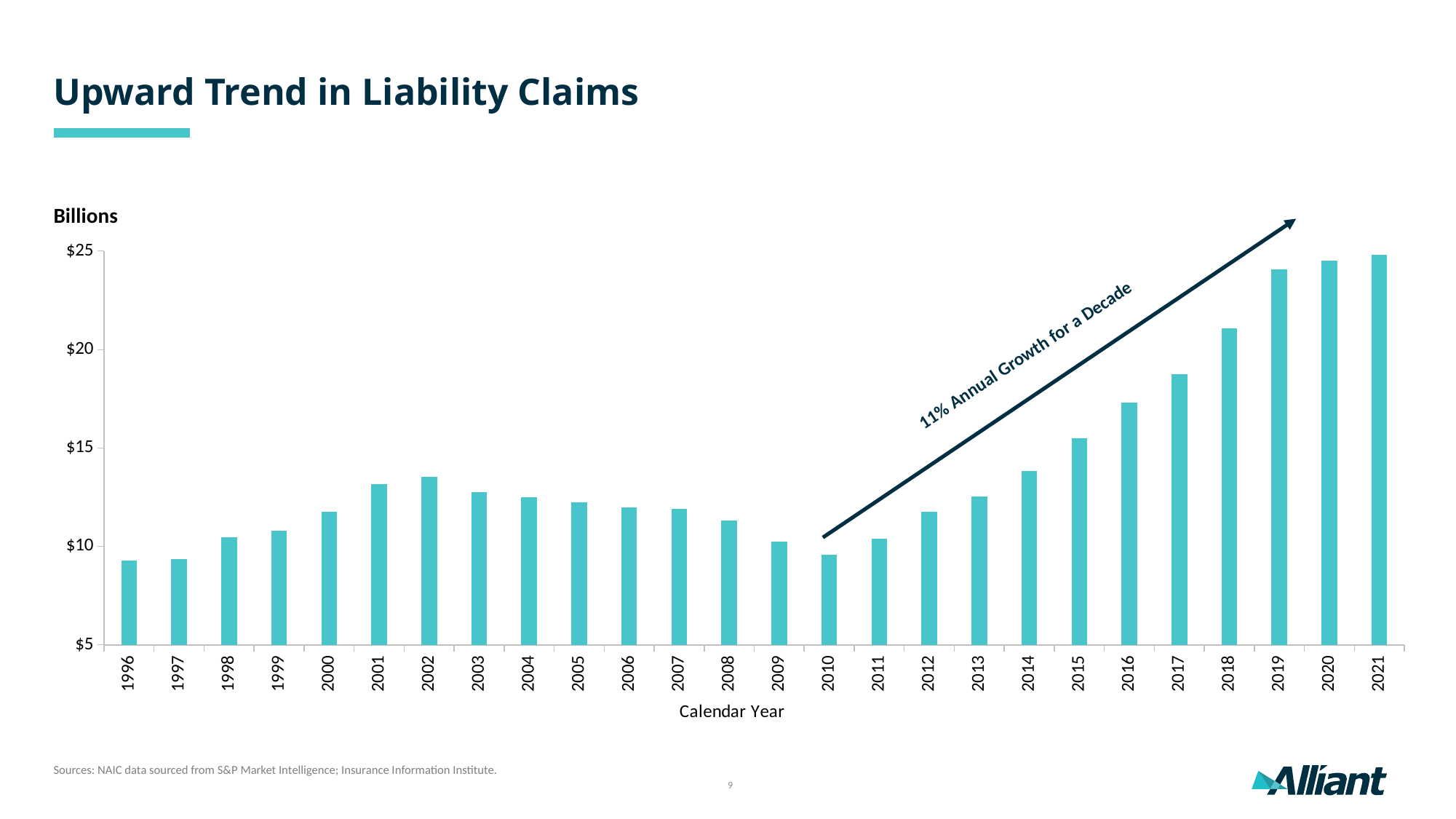
Is the value for 2021 greater or less than $20? greater How many years (bars) are plotted on the chart? 26 Do the values rise or fall from 2010 to 2021? Rise Which year has the highest value on the chart? 2021 Which is larger, the value for 2002 or the value for 2010? 2002 Is the value for 2016 greater or less than $15? greater Which is larger, the value for 2019 or the value for 2014? 2019 What kind of chart is shown on the slide? Bar chart What growth rate does the annotation arrow on the chart state? 11% Annual Growth for a Decade Is the value for 2018 greater or less than $20? greater